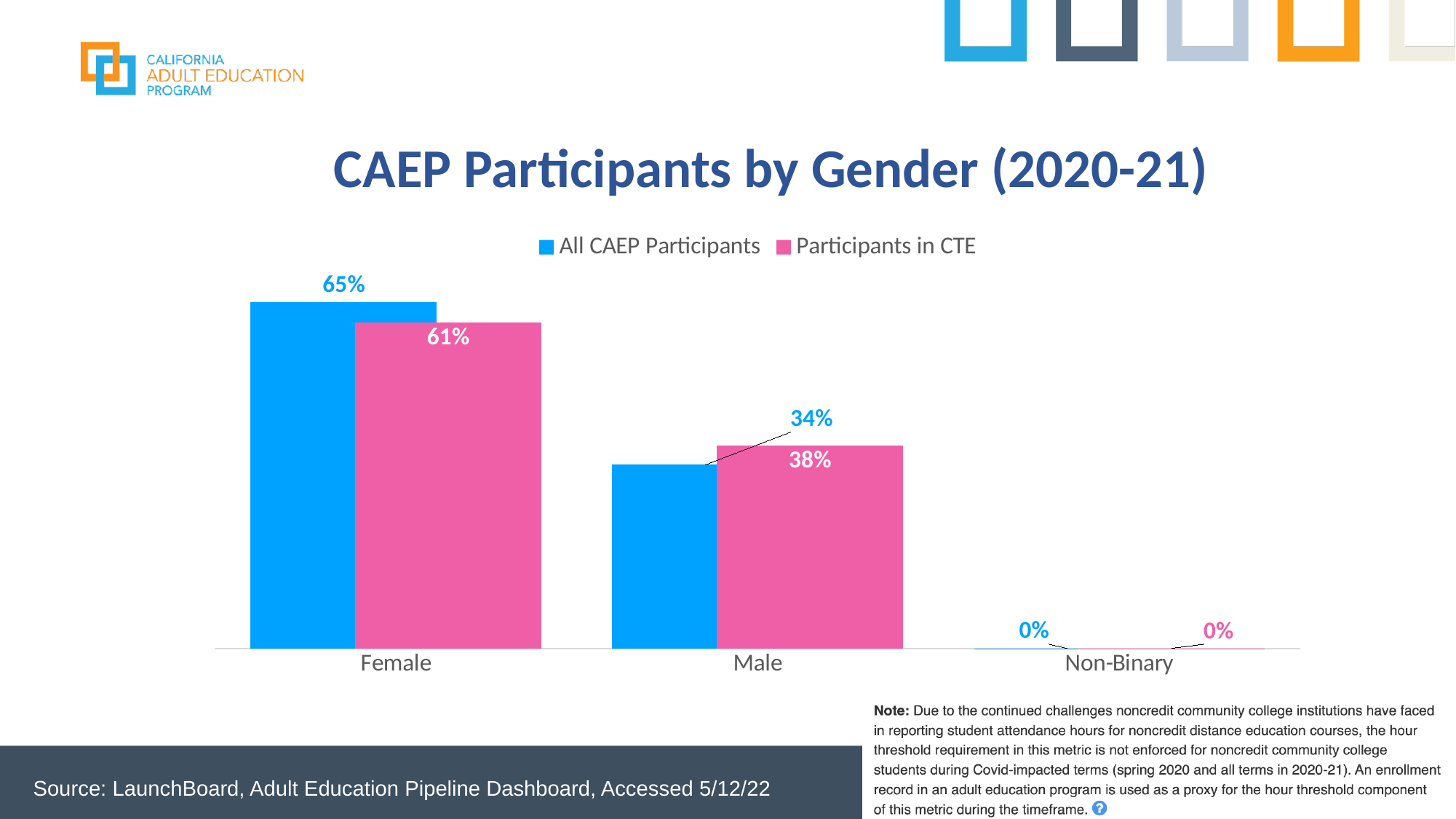
How many series does the legend list? 2 What is the difference between the All CAEP Participants and Participants in CTE values for Male? 4% What kind of chart is shown on the slide? Bar chart What is the difference between the Female and Male values for All CAEP Participants? 31% What percentage of All CAEP Participants are Female? 65% What percentage of Participants in CTE are Male? 38% How many gender categories are shown on the x axis? 3 What is the value for Participants in CTE in the Female category? 61% What is the value for All CAEP Participants in the Non-Binary category? 0% For the Male category, which series has the larger value: All CAEP Participants or Participants in CTE? Participants in CTE Which gender category has the highest value for All CAEP Participants? Female Which gender category has the lowest value for Participants in CTE? Non-Binary